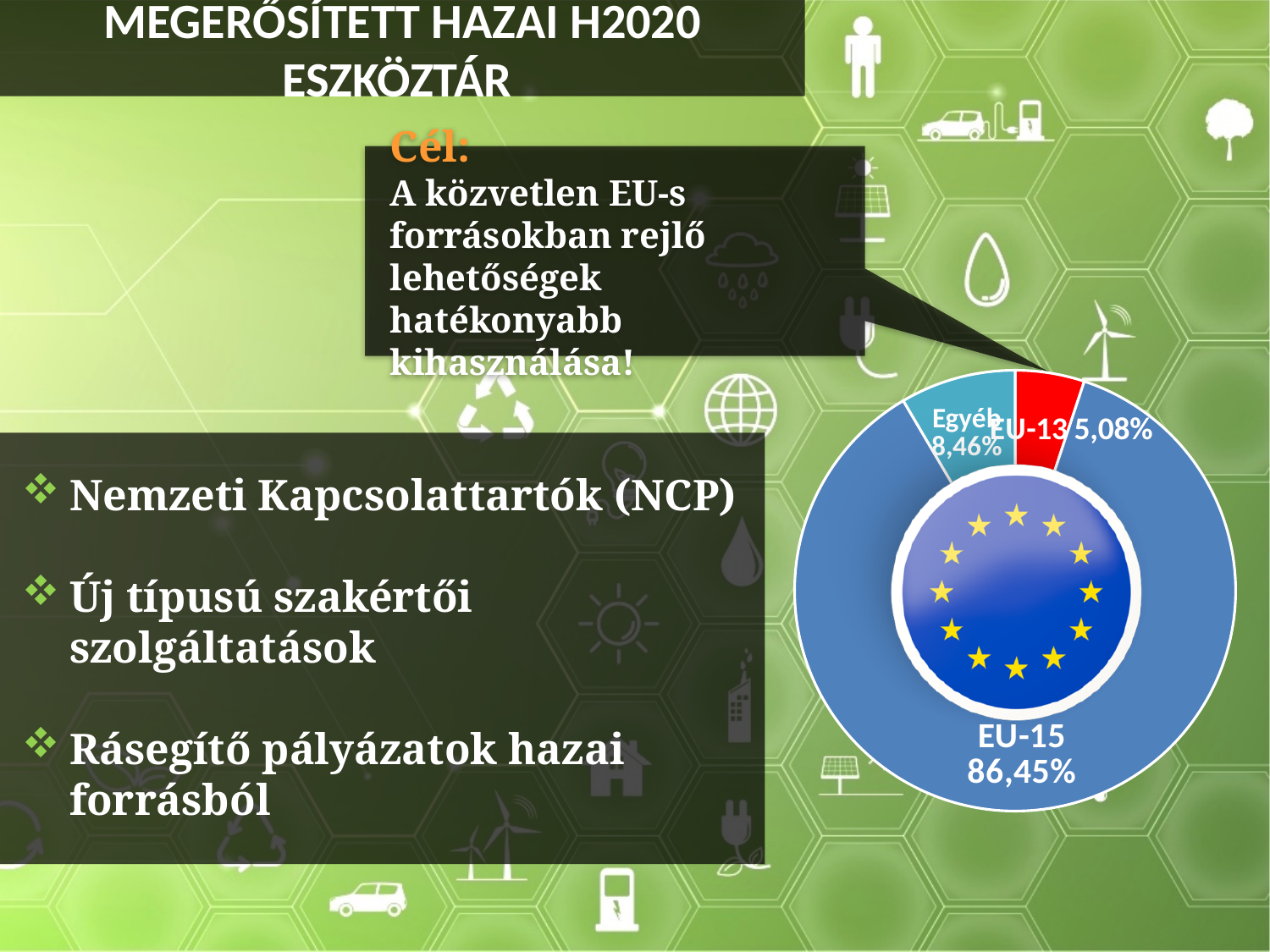
What is the value shown for EU-13 in the pie chart? 5,08% What colour is the EU-13 slice in the pie chart? Red What image is placed in the centre of the doughnut chart? The EU flag What is the difference between the EU-15 and EU-13 shares in the pie chart? 81,37% Which is larger in the pie chart, Egyéb or EU-13? Egyéb What is the difference between the Egyéb and EU-13 shares in the pie chart? 3,38% How many slices does the pie chart have? 3 Which slice of the pie chart is the largest? EU-15 What kind of chart is shown on the right side of the slide? Pie chart (doughnut) Which slice of the pie chart is the smallest? EU-13 What is the value shown for EU-15 in the pie chart? 86,45% What is the value shown for Egyéb in the pie chart? 8,46%